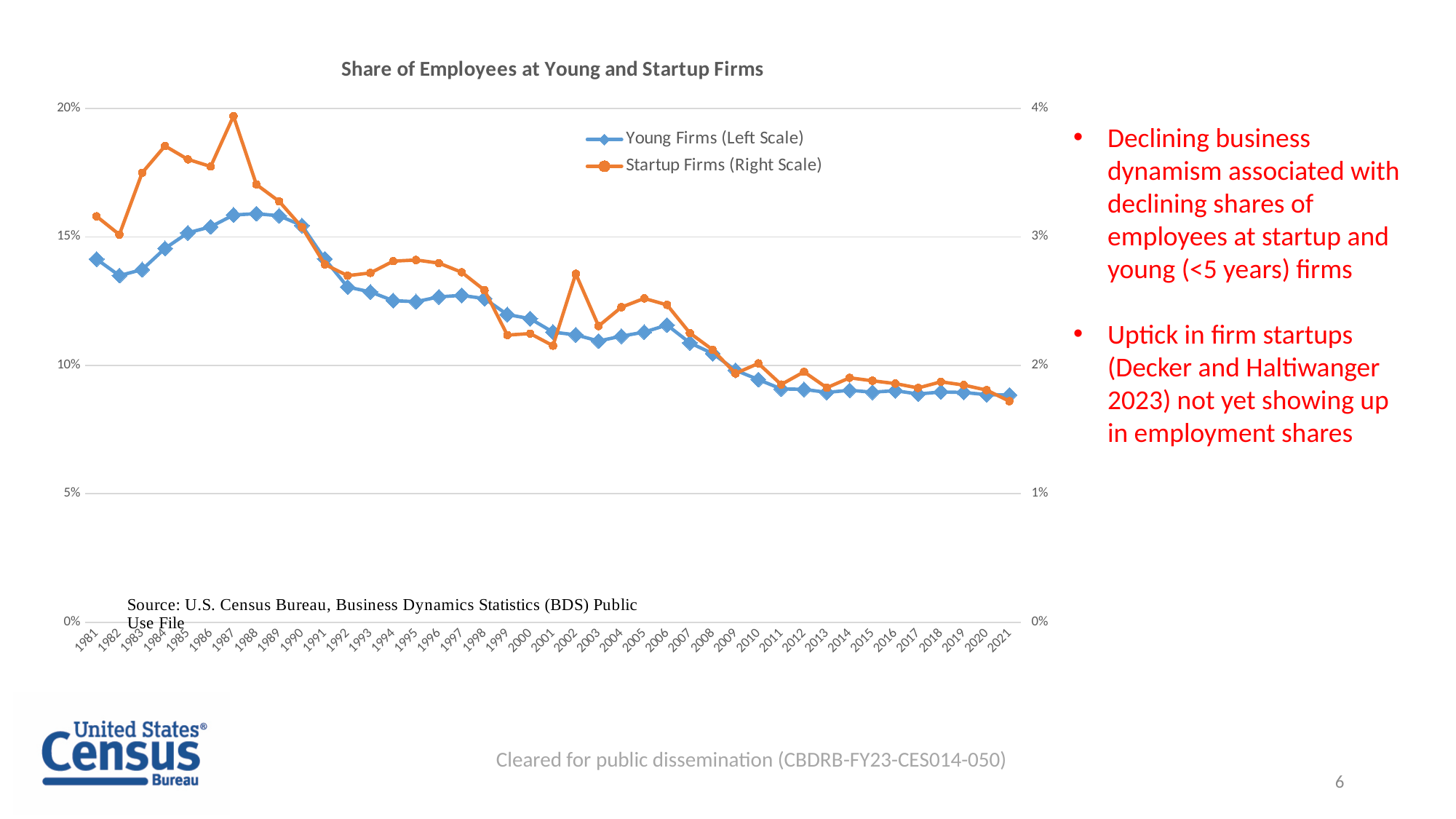
What kind of chart is shown on the slide? Line chart Which year has the larger Young Firms value, 1987 or 2021? 1987 What is the title of the chart? Share of Employees at Young and Startup Firms Is the Startup Firms value for 1987 greater or less than 3% on the right scale? greater Is the Young Firms value for 2021 greater or less than 10%? less In which year does the Startup Firms series reach its lowest value? 2021 Is the Young Firms value for 1981 greater or less than 10%? greater In which year does the Startup Firms series reach its highest value? 1987 How many years are shown along the x axis? 41 Which series is plotted against the right scale? Startup Firms Overall, do the Young Firms values rise or fall from 1981 to 2021? Fall How many series does the legend list? 2